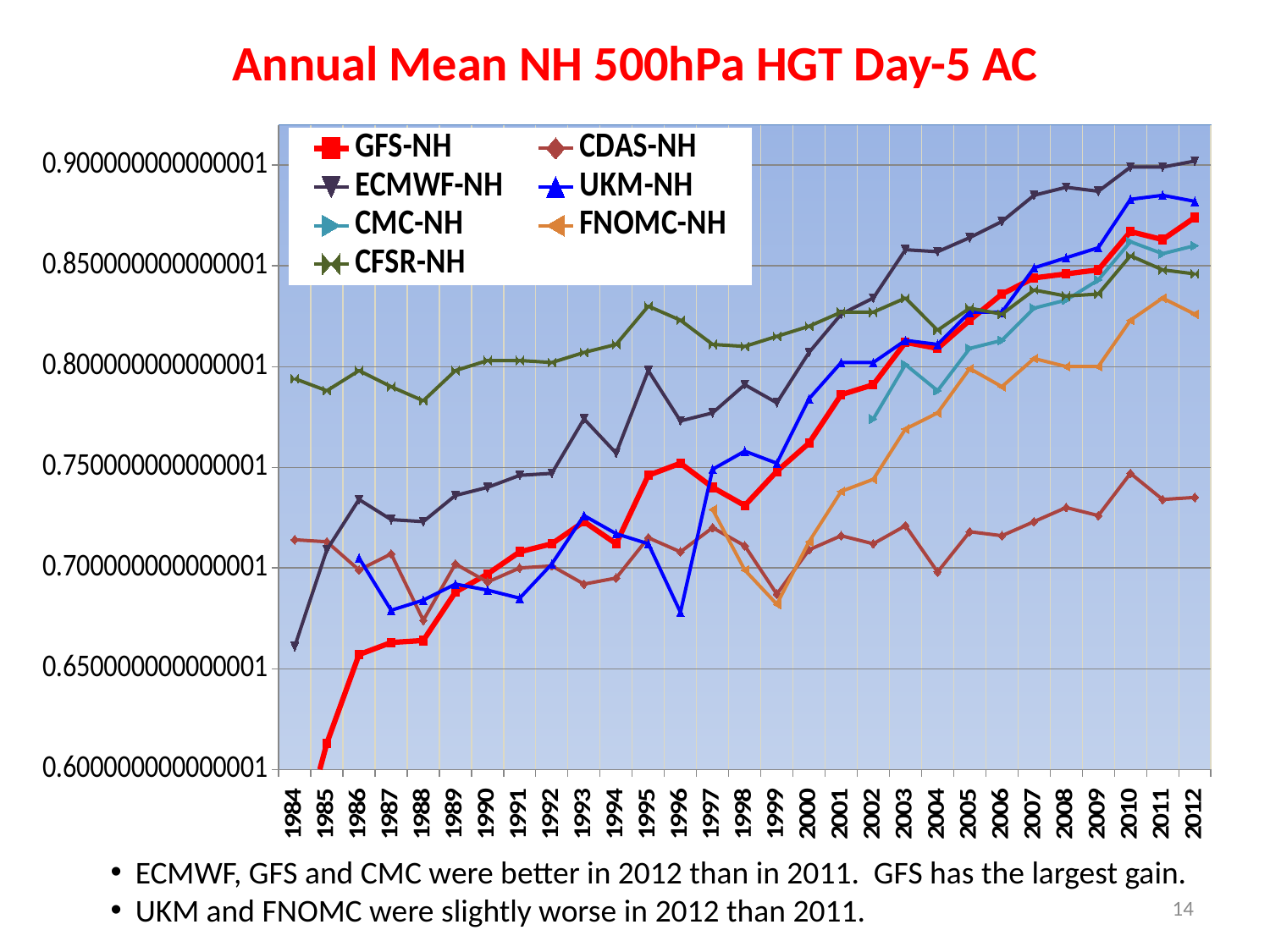
In 1984, which is higher: CFSR-NH or GFS-NH? CFSR-NH How many years are plotted along the x axis? 29 Which series has the highest value in 2012? ECMWF-NH What colour is the GFS-NH line in the chart? red Is the value for CDAS-NH in 2012 greater or less than 0.75? less What is the title of the chart? Annual Mean NH 500hPa HGT Day-5 AC Which series has the lowest value in 2012? CDAS-NH Is the value for ECMWF-NH in 2012 greater or less than 0.85? greater What kind of chart is shown on the slide? line chart How many series does the legend list? 7 Does the GFS-NH series generally rise or fall from 1984 to 2012? rise Which series has the lowest value in 1984? GFS-NH